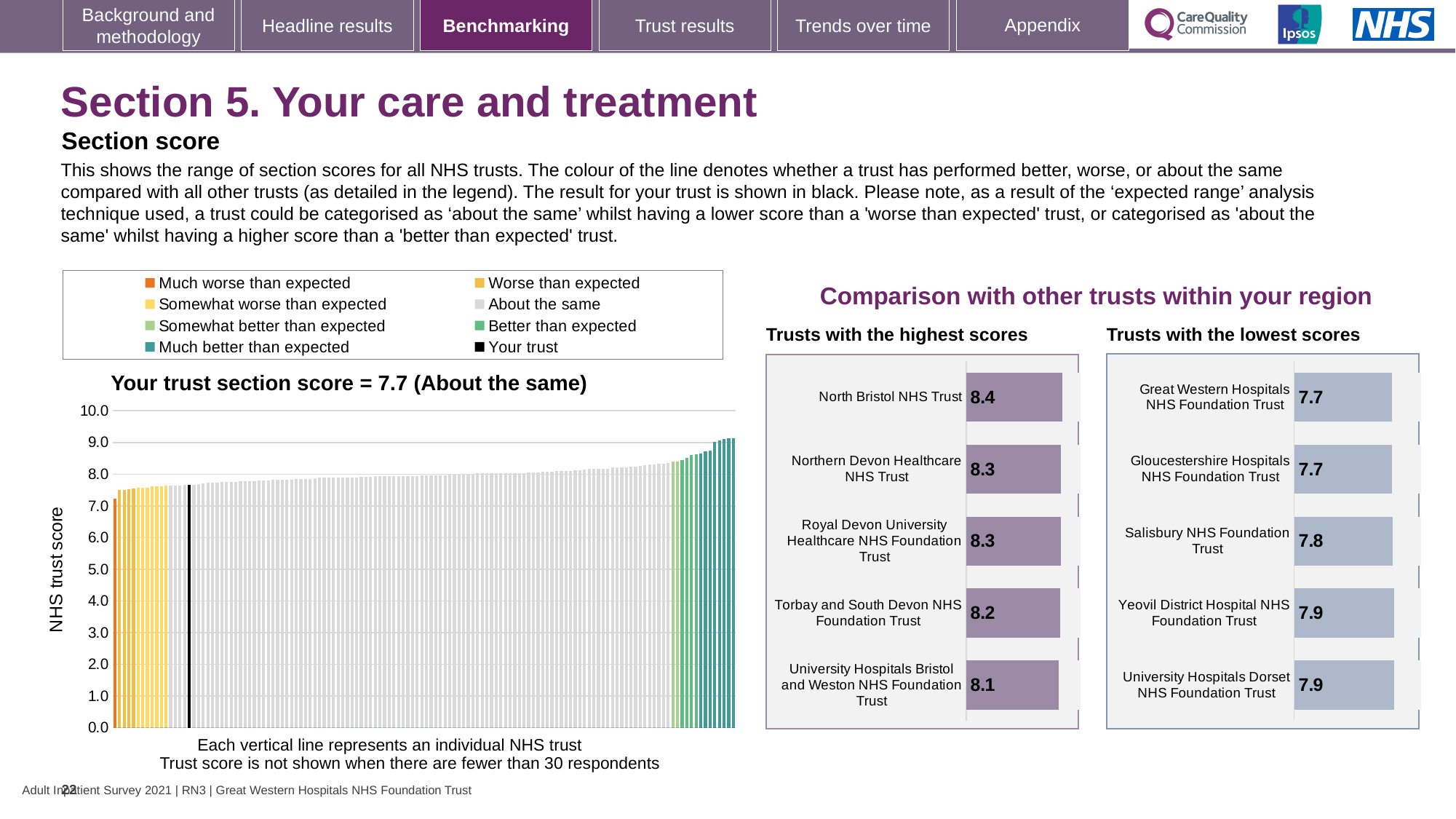
In the 'Trusts with the lowest scores' chart, what is the score for Salisbury NHS Foundation Trust? 7.8 In the 'Trusts with the highest scores' chart, what is the difference between the scores of North Bristol NHS Trust and University Hospitals Bristol and Weston NHS Foundation Trust? 0.3 In the 'Trusts with the highest scores' chart, what is the score for North Bristol NHS Trust? 8.4 In the 'Your trust section score' chart, what is the label on the vertical axis? NHS trust score How many entries does the legend above the 'Your trust section score' chart list? 8 In the 'Your trust section score' chart, is the value for your trust (the black line) greater or less than 8.0? less In the 'Trusts with the highest scores' chart, which trust has the lowest score? University Hospitals Bristol and Weston NHS Foundation Trust In the 'Your trust section score' chart, what kind of chart is shown? bar chart In the 'Your trust section score' chart, what is the section score for your trust? 7.7 In the 'Trusts with the lowest scores' chart, which has the larger score: Yeovil District Hospital NHS Foundation Trust or Great Western Hospitals NHS Foundation Trust? Yeovil District Hospital NHS Foundation Trust In the 'Your trust section score' chart, do the trust scores rise or fall from left to right along the x axis? rise In the 'Trusts with the highest scores' chart, how many trusts are shown? 5